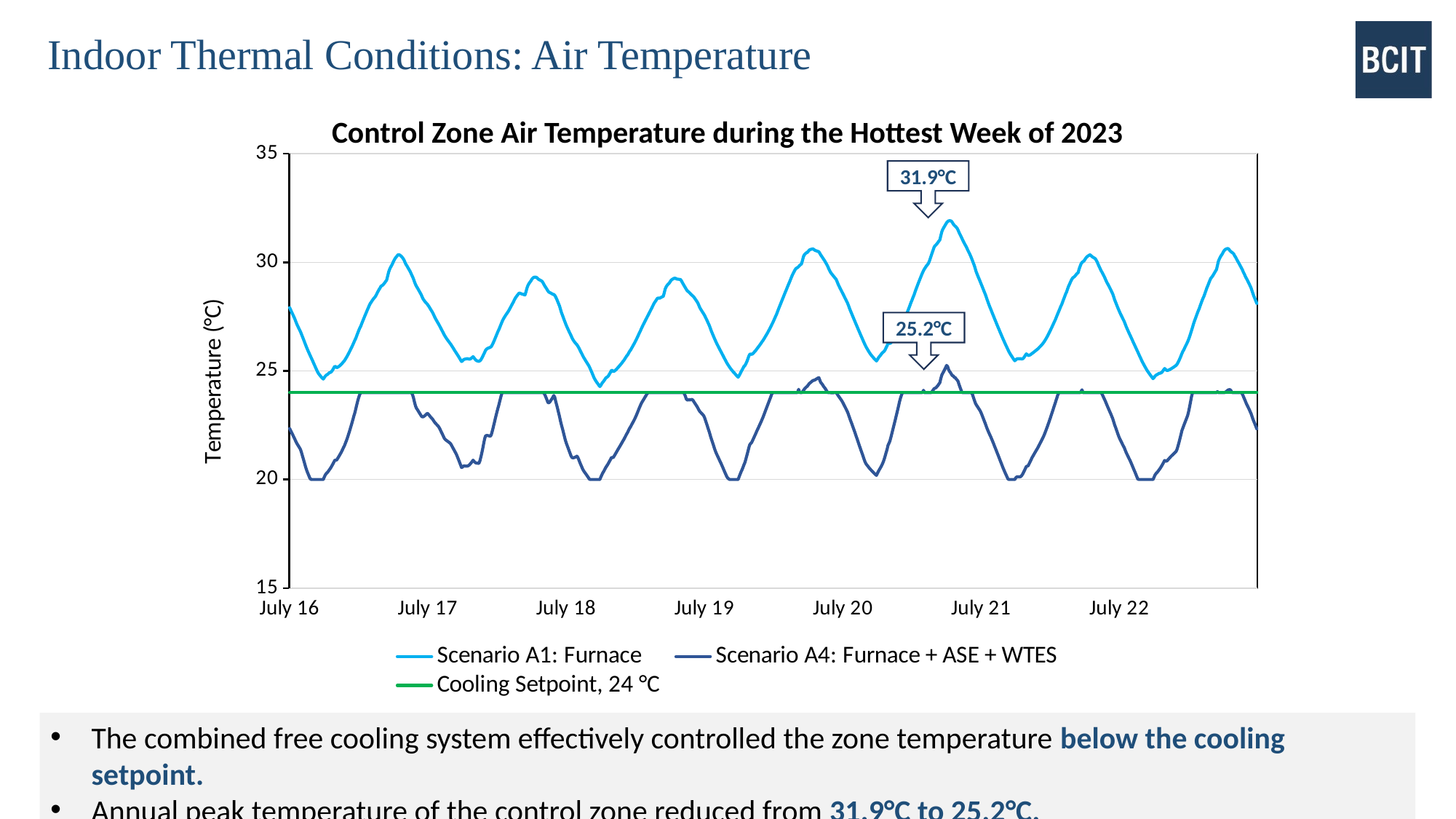
How many series does the chart legend list? 3 Is the lowest temperature reached by Scenario A4: Furnace + ASE + WTES greater or less than 25? less What is the label of the y axis? Temperature (°C) What is the peak temperature labelled for Scenario A4: Furnace + ASE + WTES? 25.2°C Is the labelled peak of Scenario A1: Furnace greater or less than 30 on the temperature axis? greater What is the difference between the labelled peak temperatures of Scenario A1 (31.9°C) and Scenario A4 (25.2°C)? 6.7°C What kind of chart is shown on the slide? Line chart What is the peak temperature labelled for Scenario A1: Furnace? 31.9°C What is the value of the Cooling Setpoint line? 24 °C Which series has the higher labelled peak temperature, Scenario A1: Furnace or Scenario A4: Furnace + ASE + WTES? Scenario A1: Furnace How many dates are labelled on the x axis? 7 What is the title of the chart? Control Zone Air Temperature during the Hottest Week of 2023